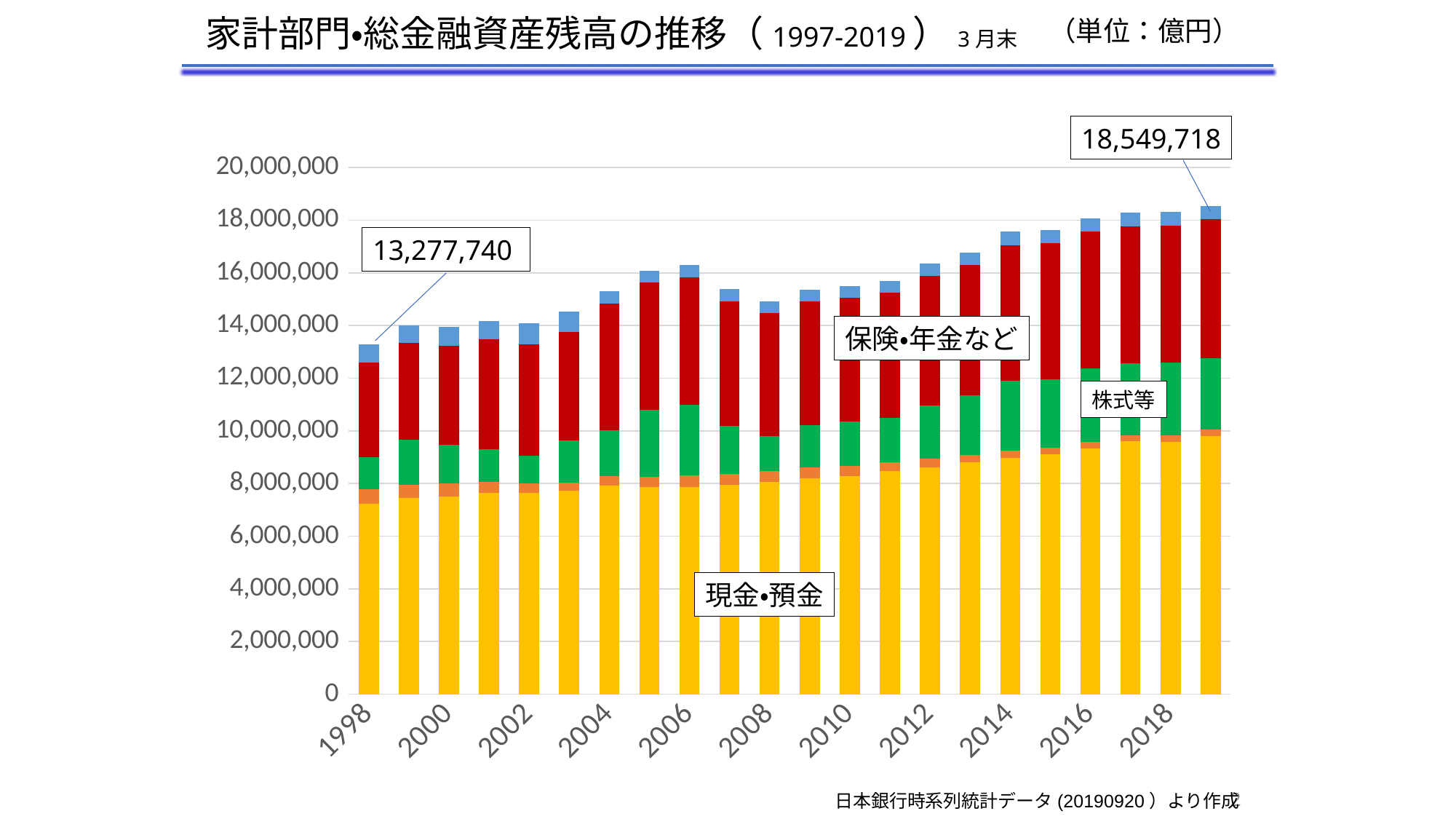
What is the total value labeled on the leftmost bar? 13,277,740 Which bar has the highest total? The rightmost bar (2019) What is the difference between the labeled total of the rightmost bar (18,549,718) and the labeled total of the leftmost bar (13,277,740)? 5,271,978 What is the total value labeled on the rightmost bar (2019)? 18,549,718 Which category forms the bottom (yellow) segment of each stacked bar? 現金・預金 Is the 現金・預金 segment for 2018 greater or less than 8,000,000? greater Which bar has the lowest total? The leftmost bar Do the total values generally rise or fall from left to right along the x axis? Rise Is the total value for 2008 greater or less than 16,000,000? less What kind of chart is shown on the slide? Stacked bar chart What unit is stated for the values in the chart? 億円 Which is larger, the total for 2014 or the total for 2010? 2014